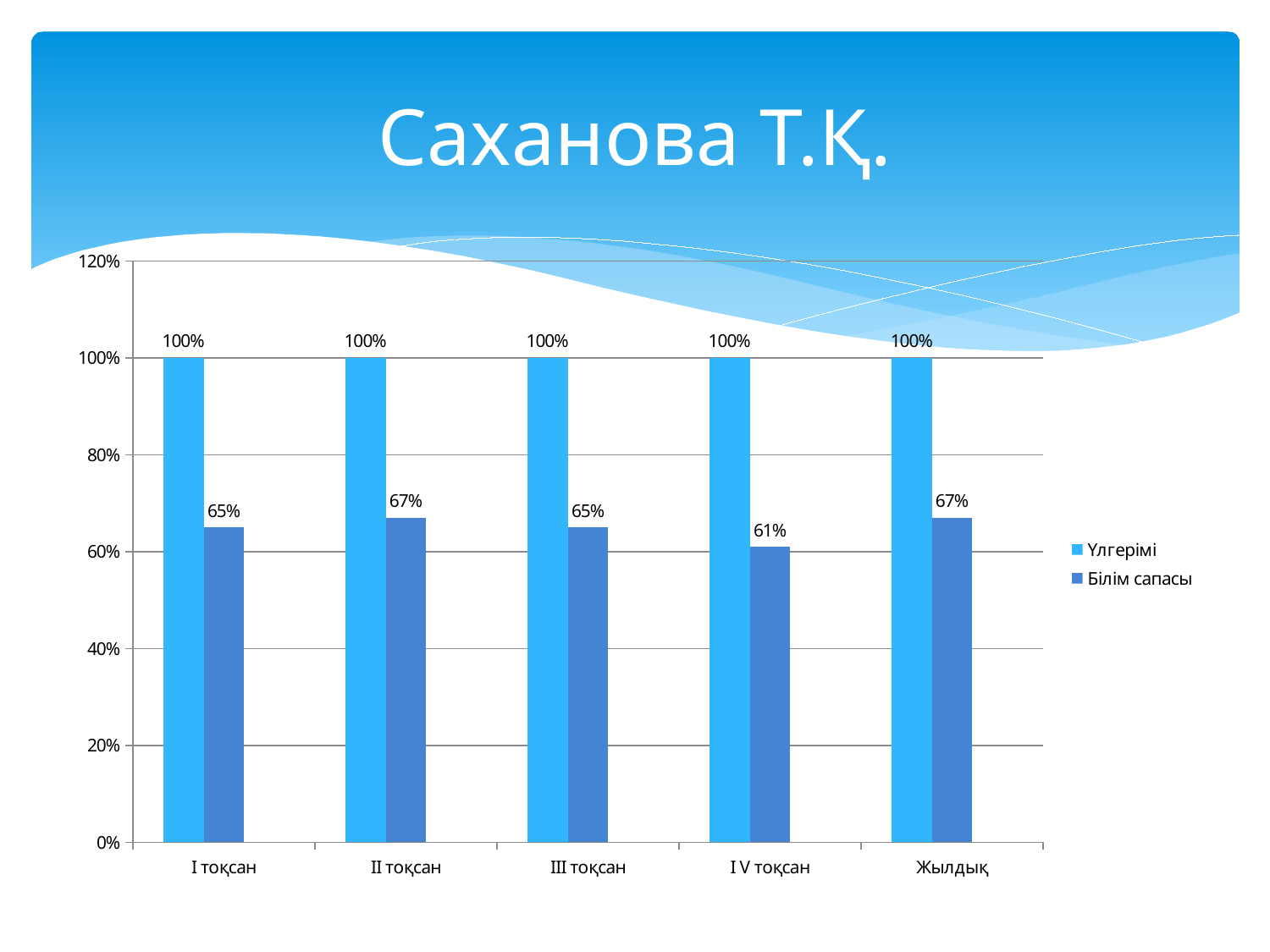
What is the value of Білім сапасы for II тоқсан? 67% What is the title of the slide? Саханова Т.Қ. What is the difference between Үлгерімі and Білім сапасы for III тоқсан? 35% What kind of chart is shown on the slide? bar chart Which category has the lowest Білім сапасы value? I V тоқсан What is the value of Білім сапасы for I V тоқсан? 61% How many categories are shown on the x axis? 5 What is the difference between the Білім сапасы values for II тоқсан and I V тоқсан? 6% Which is larger, the Білім сапасы value for II тоқсан or for I V тоқсан? II тоқсан What is the value of Білім сапасы for I тоқсан? 65% What is the value of Үлгерімі for Жылдық? 100% How many series does the legend list? 2